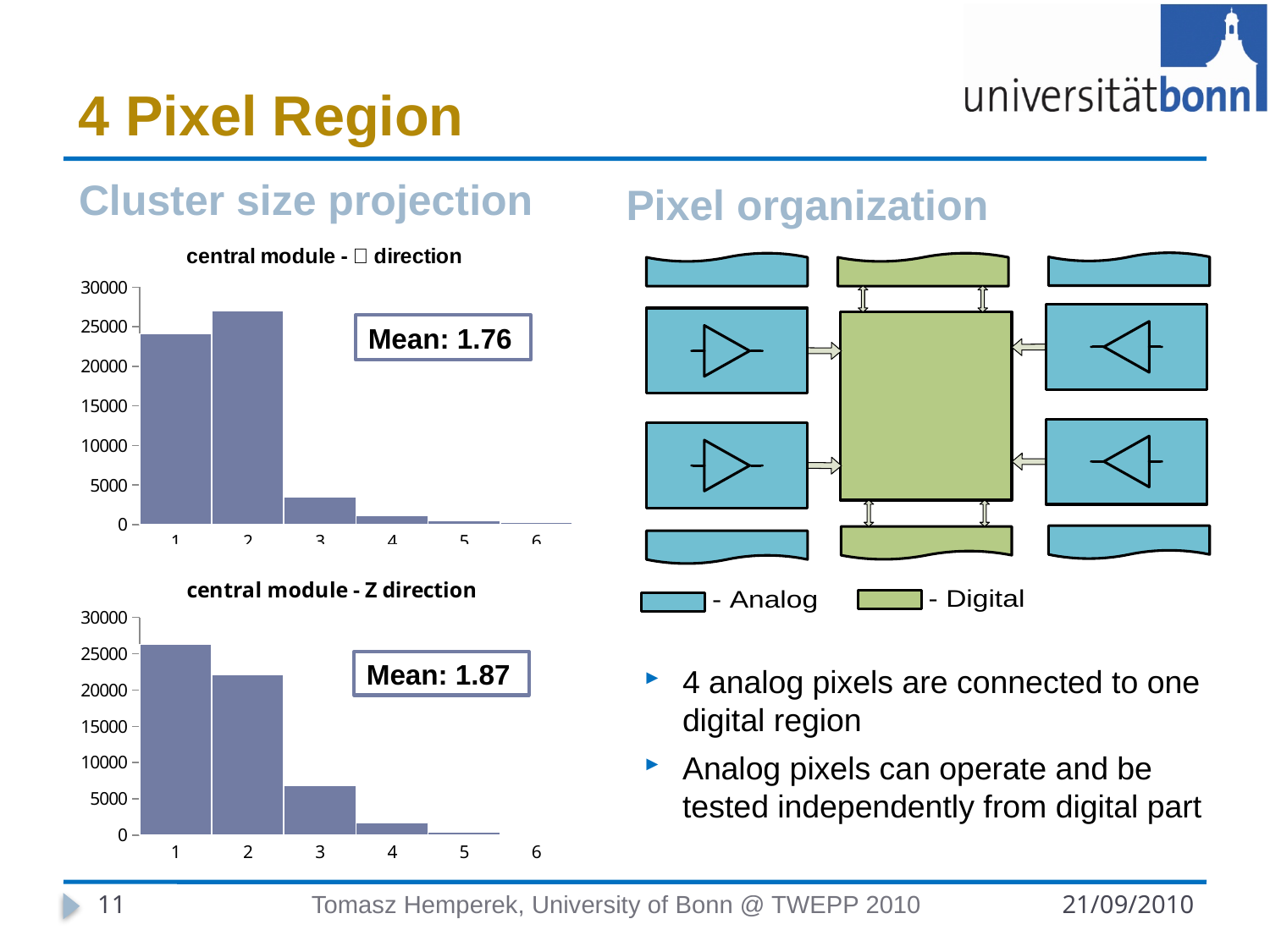
In the top chart (central module, first direction), is the value for category 3 greater or less than 5000? less In the 'central module - Z direction' chart, is the value for category 2 greater or less than 25000? less What mean value is printed on the 'central module - Z direction' chart? Mean: 1.87 What kind of chart is the 'central module - Z direction' chart? bar chart In the top chart (central module, first direction), which category has the highest value? 2 How many categories are shown on the x axis of the 'central module - Z direction' chart? 6 In the 'central module - Z direction' chart, which is larger, the value for category 1 or category 2? category 1 In the 'central module - Z direction' chart, which category has the highest value? 1 In the 'central module - Z direction' chart, is the value for category 3 greater or less than 5000? greater In the 'central module - Z direction' chart, do the values rise or fall from category 1 to category 6? fall In the top chart (central module, first direction), which is larger, the value for category 1 or category 2? category 2